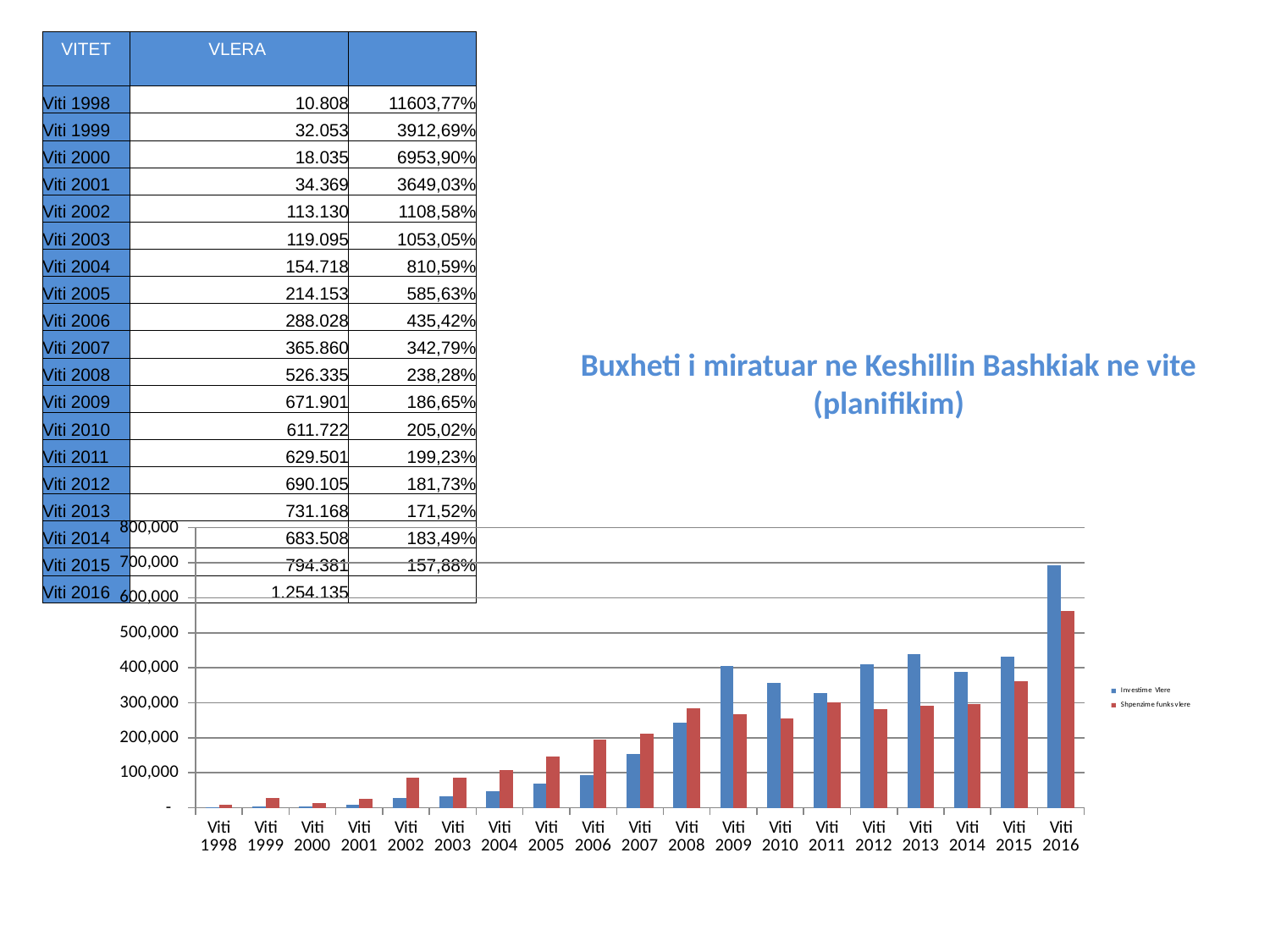
Do the Investime Vlere values generally rise or fall from Viti 1998 to Viti 2016? rise Which series is drawn in blue in the chart? Investime Vlere In which year is the Investime Vlere bar the lowest? Viti 1998 What kind of chart is shown on the slide? bar chart Is the Investime Vlere value for Viti 2005 greater or less than 100,000? less Is the Investime Vlere value for Viti 2016 greater or less than 600,000? greater For Viti 2006, which is larger: Investime Vlere or Shpenzime funks vlere? Shpenzime funks vlere What is the title of the chart? Buxheti i miratuar ne Keshillin Bashkiak ne vite (planifikim) How many years (categories) are shown on the x axis of the chart? 19 How many series does the chart legend list? 2 Is the Shpenzime funks vlere value for Viti 2008 greater or less than 300,000? less In which year is the Investime Vlere bar the highest? Viti 2016